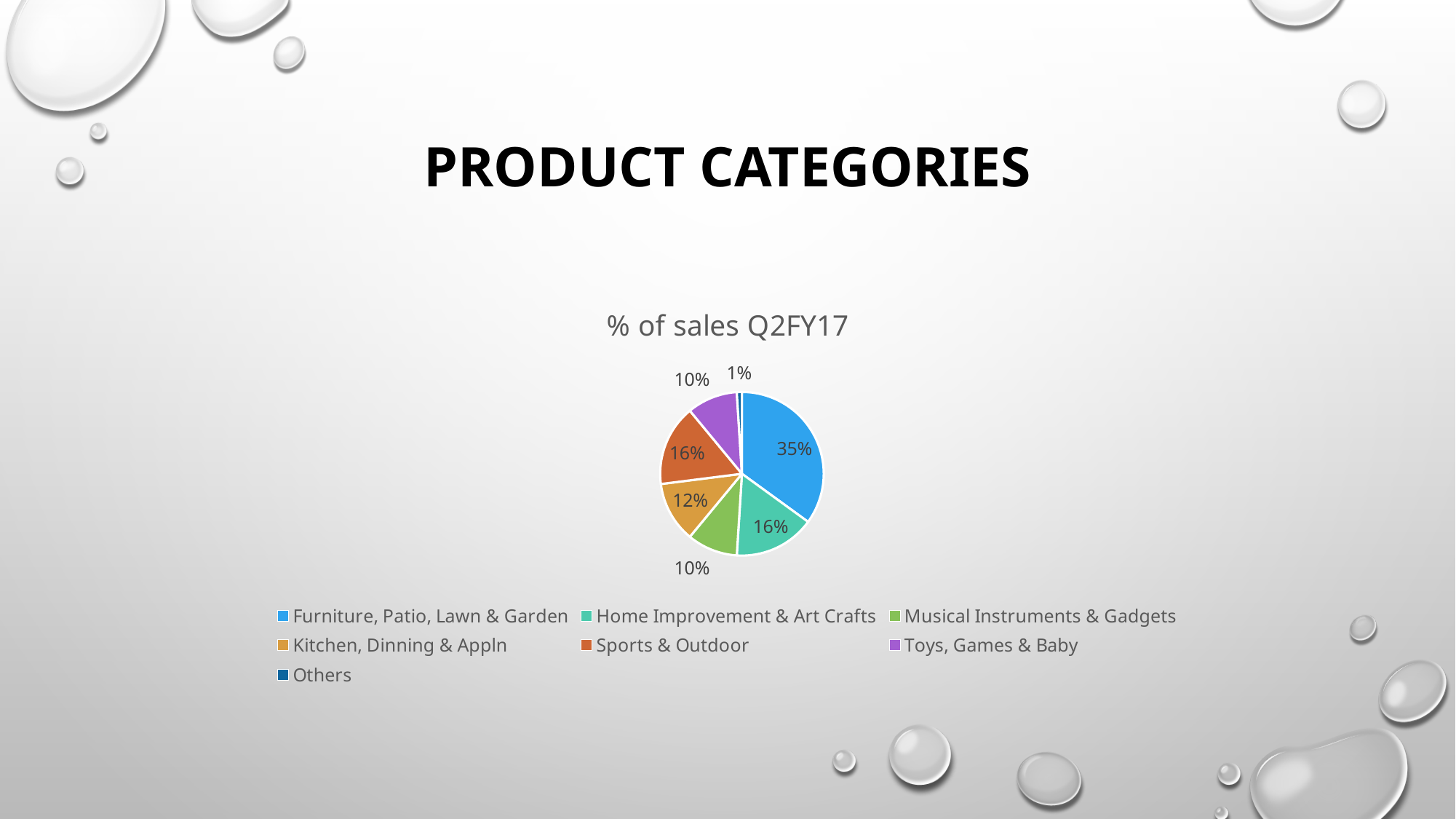
What is the title of the chart? % of sales Q2FY17 What percentage of sales is Toys, Games & Baby? 10% How many product categories are shown in the pie chart? 7 Which product category has the largest share of sales? Furniture, Patio, Lawn & Garden What type of chart is shown on the slide? Pie chart What share of sales does Furniture, Patio, Lawn & Garden account for? 35% What share of sales does Others represent? 1% Which product category has the smallest share of sales? Others What colour is the slice for Sports & Outdoor? Orange What percentage of sales is Kitchen, Dinning & Appln? 12% What is the difference in percentage points between Furniture, Patio, Lawn & Garden and Sports & Outdoor? 19 Which has a larger share of sales, Kitchen, Dinning & Appln or Musical Instruments & Gadgets? Kitchen, Dinning & Appln